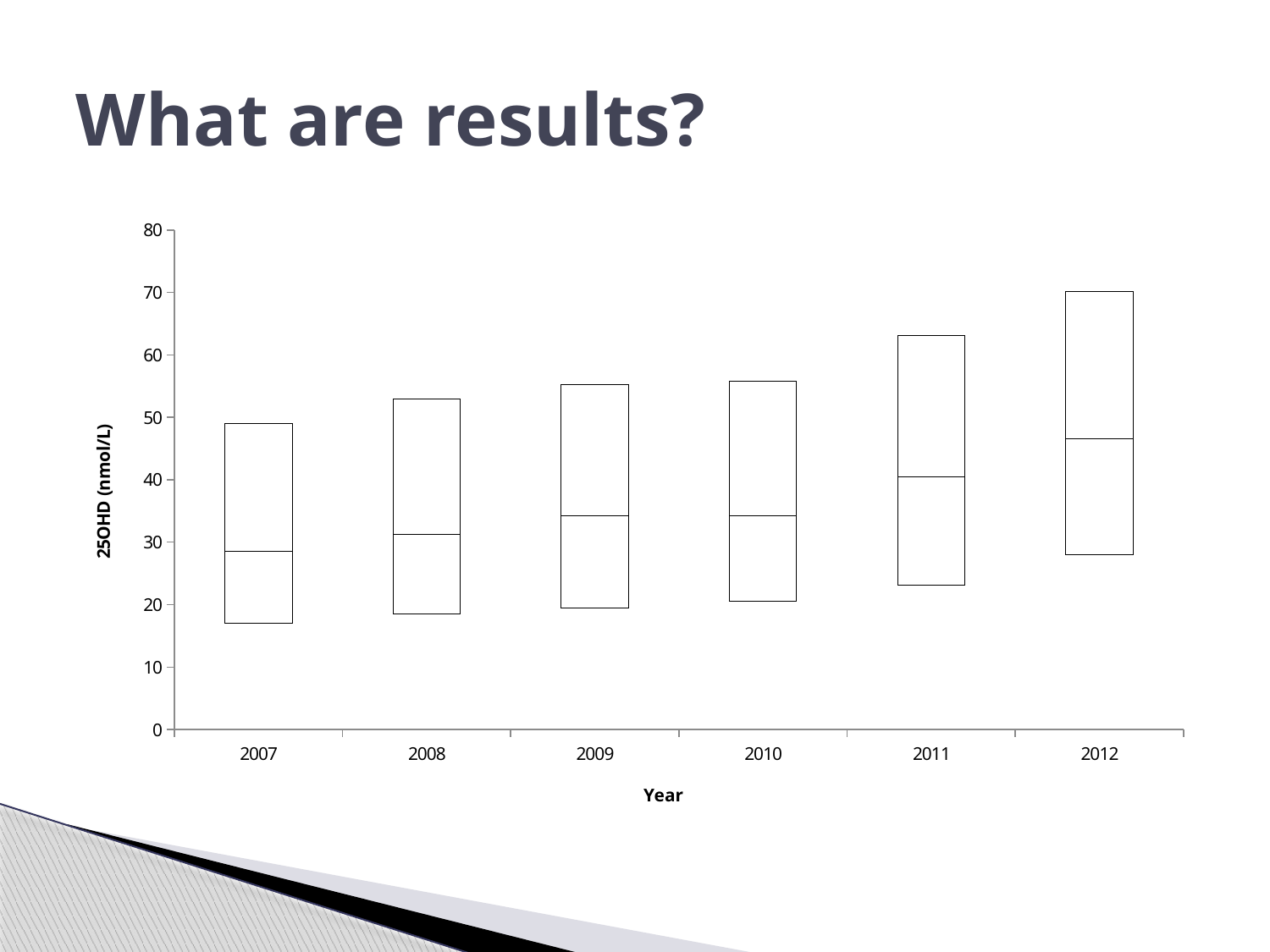
Is the top of the box for 2012 greater or less than 60? greater What kind of chart is shown on the slide? bar chart Which year has the highest middle line in its box? 2012 Is the middle line of the box for 2012 greater or less than 40? greater Which year has the lowest bottom of its box? 2007 What is the label of the horizontal axis of the chart? Year How many years are shown on the x axis of the chart? 6 Is the bottom of the box for 2007 greater or less than 20? less What is the label of the vertical axis of the chart? 25OHD (nmol/L) Do the middle lines of the boxes rise or fall from 2007 to 2012? rise Which year has the highest top of its box? 2012